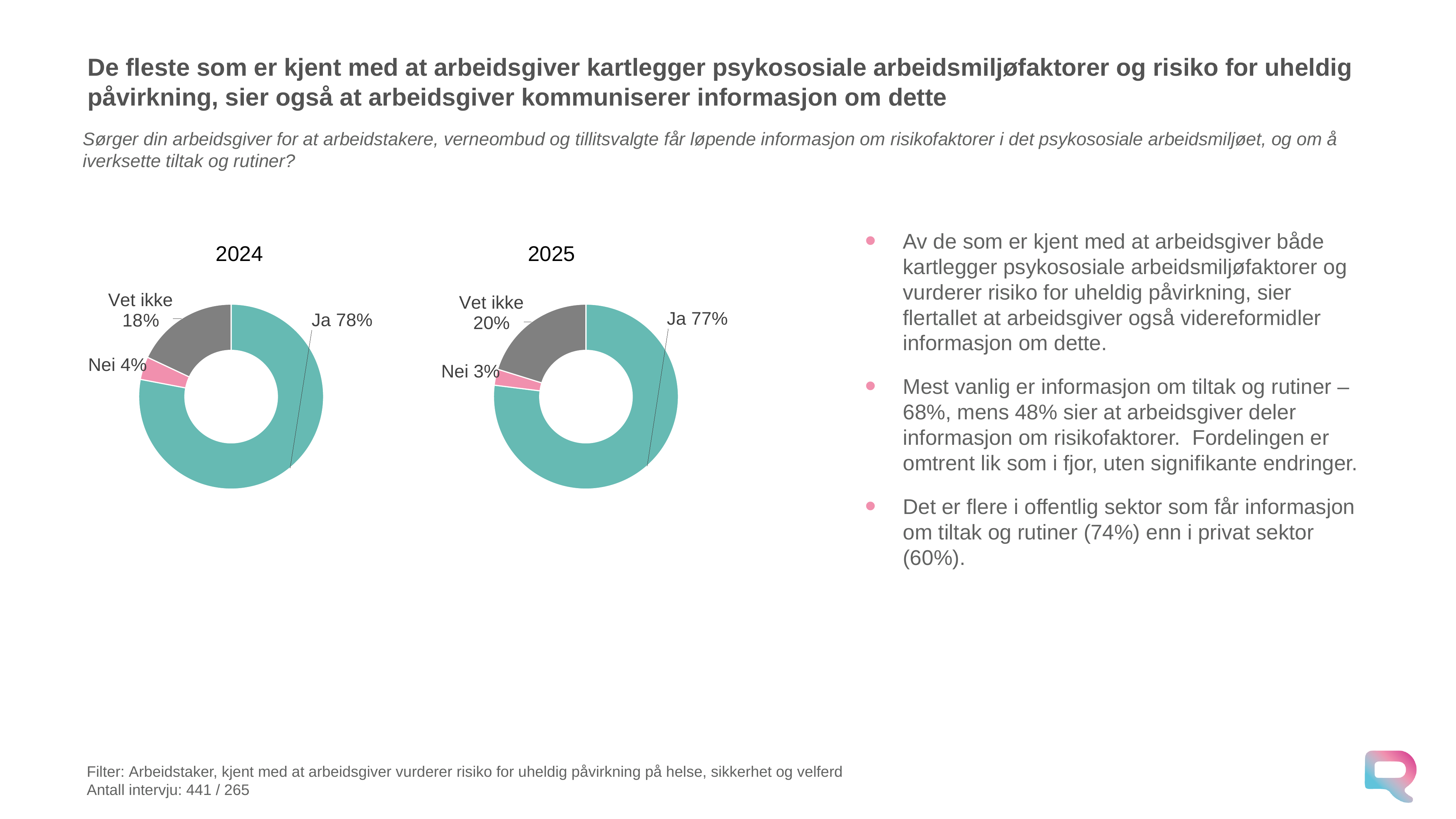
How many categories are shown in the 2025 chart? 3 In the 2025 chart, what share of respondents answered "Nei"? 3% In the 2025 chart, what share of respondents answered "Vet ikke"? 20% Is the "Vet ikke" share larger in the 2024 chart or the 2025 chart? 2025 What colour is the "Nei" slice in the 2025 chart? Pink In the 2024 chart, what share of respondents answered "Ja"? 78% In the 2024 chart, which category has the largest share? Ja What is the difference between the "Ja" share in the 2024 chart and the "Ja" share in the 2025 chart? 1 percentage point In the 2024 chart, what share of respondents answered "Nei"? 4% In the 2024 chart, what is the difference between the "Vet ikke" share and the "Nei" share? 14 percentage points In the 2025 chart, which category has the smallest share? Nei What kind of chart is the 2024 chart? Donut (pie) chart